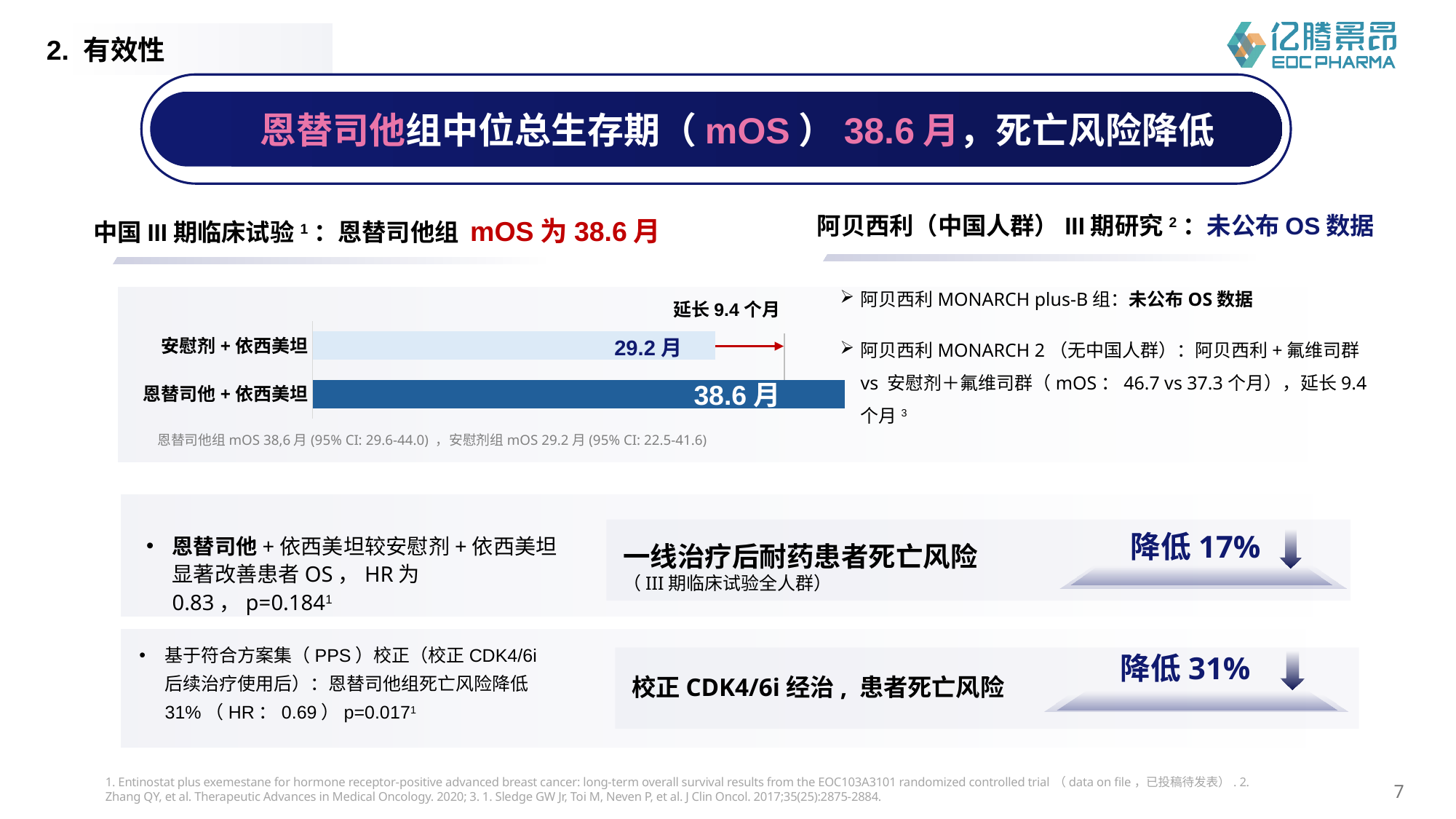
By how many months does the 恩替司他 + 依西美坦 bar exceed the 安慰剂 + 依西美坦 bar? 9.4 个月 What kind of chart is used to show the mOS comparison? bar chart Which bar is drawn in the darker blue colour? 恩替司他 + 依西美坦 What is the mOS value shown for the 安慰剂 + 依西美坦 bar? 29.2 月 Which group has the longer bar in the chart? 恩替司他 + 依西美坦 Which group has the shorter bar in the chart? 安慰剂 + 依西美坦 How many bars are plotted in the chart? 2 What annotation is written above the arrow between the two bars? 延长 9.4 个月 What is the mOS value shown for the 恩替司他 + 依西美坦 bar? 38.6 月 Is the value for 恩替司他 + 依西美坦 larger or smaller than the value for 安慰剂 + 依西美坦? larger